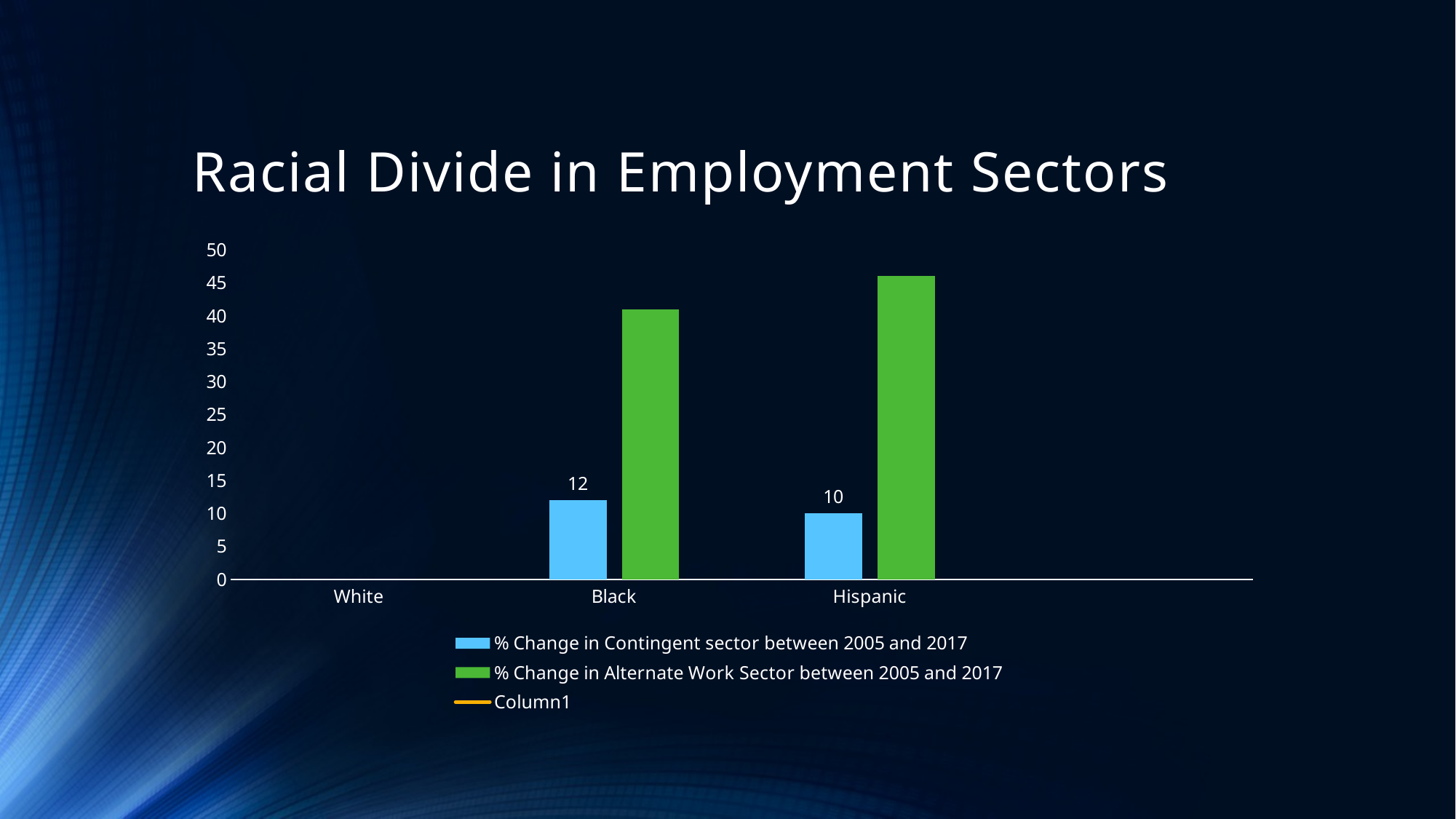
What is the value for Black in the '% Change in Contingent sector between 2005 and 2017' series? 12 What is the difference between the Black and Hispanic values in the '% Change in Contingent sector between 2005 and 2017' series? 2 What is the value for Hispanic in the '% Change in Contingent sector between 2005 and 2017' series? 10 For Hispanic, which series has the larger value, the Contingent sector or the Alternate Work Sector? % Change in Alternate Work Sector between 2005 and 2017 How many categories are shown on the x axis of the chart? 3 Which category has the highest value in the '% Change in Alternate Work Sector between 2005 and 2017' series? Hispanic How many entries does the chart's legend list? 3 What is the title of the slide containing the chart? Racial Divide in Employment Sectors Is the value for Hispanic in the '% Change in Alternate Work Sector between 2005 and 2017' series greater or less than 40? greater What kind of chart is shown on the slide? Bar chart Is the value for Black in the '% Change in Alternate Work Sector between 2005 and 2017' series greater or less than 35? greater Which category has the higher value in the '% Change in Contingent sector between 2005 and 2017' series, Black or Hispanic? Black